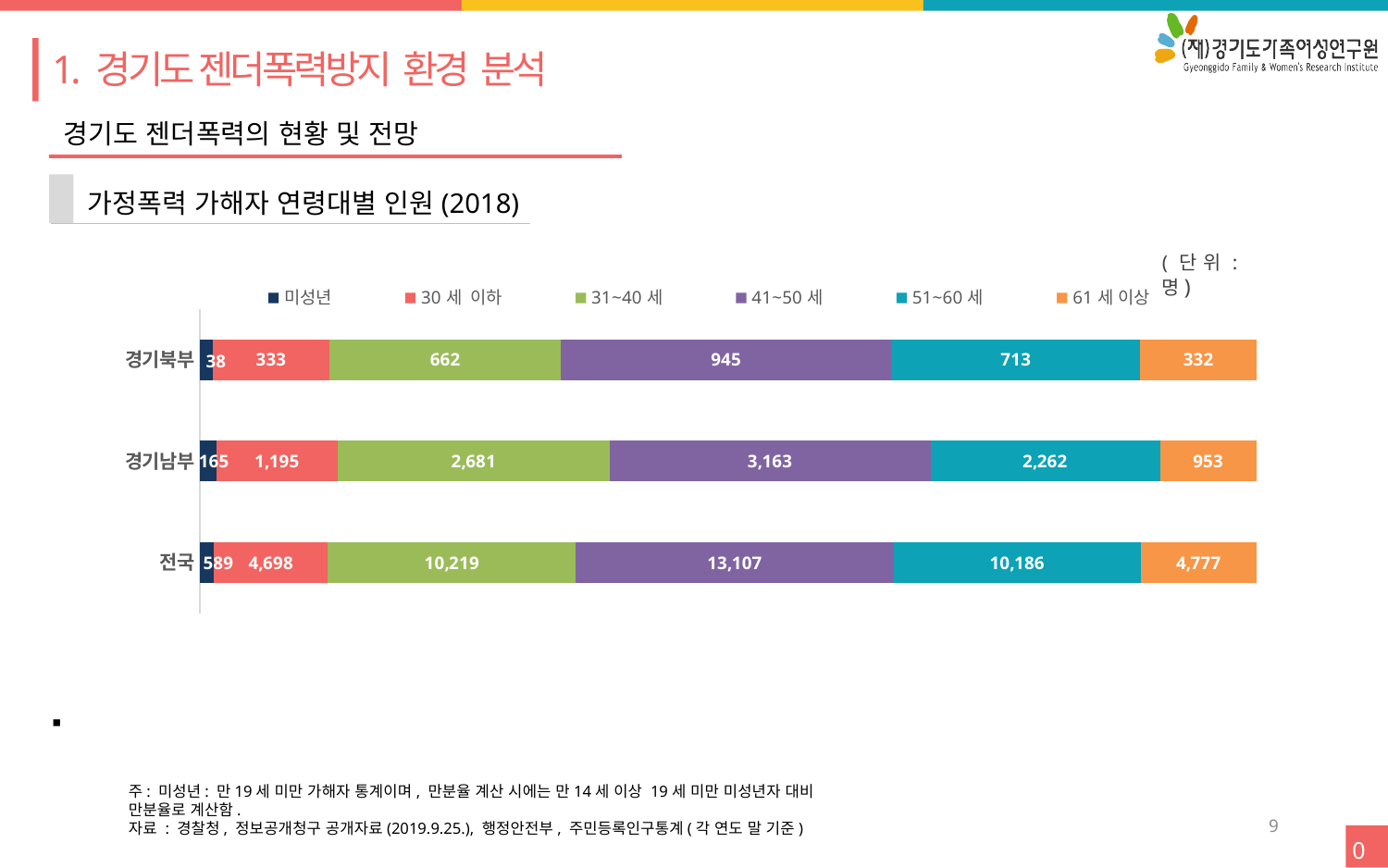
What is the total of the 경기북부 bar across all age groups? 3,023 How many categories (regions) are plotted on the chart? 3 Which age group has the lowest value in 경기북부? 미성년 What type of chart is shown on the slide? stacked bar chart What is the value for 41~50세 in 경기북부? 945 Which age group has the highest value in 전국? 41~50세 Which is larger in 경기북부: the 30세 이하 value or the 61세 이상 value? 30세 이하 What is the value for 51~60세 in 전국? 10,186 What is the value for 31~40세 in 경기남부? 2,681 How many series does the legend list? 6 What is the difference between the 41~50세 and 51~60세 values in 경기남부? 901 What is the value for 미성년 in 경기남부? 165